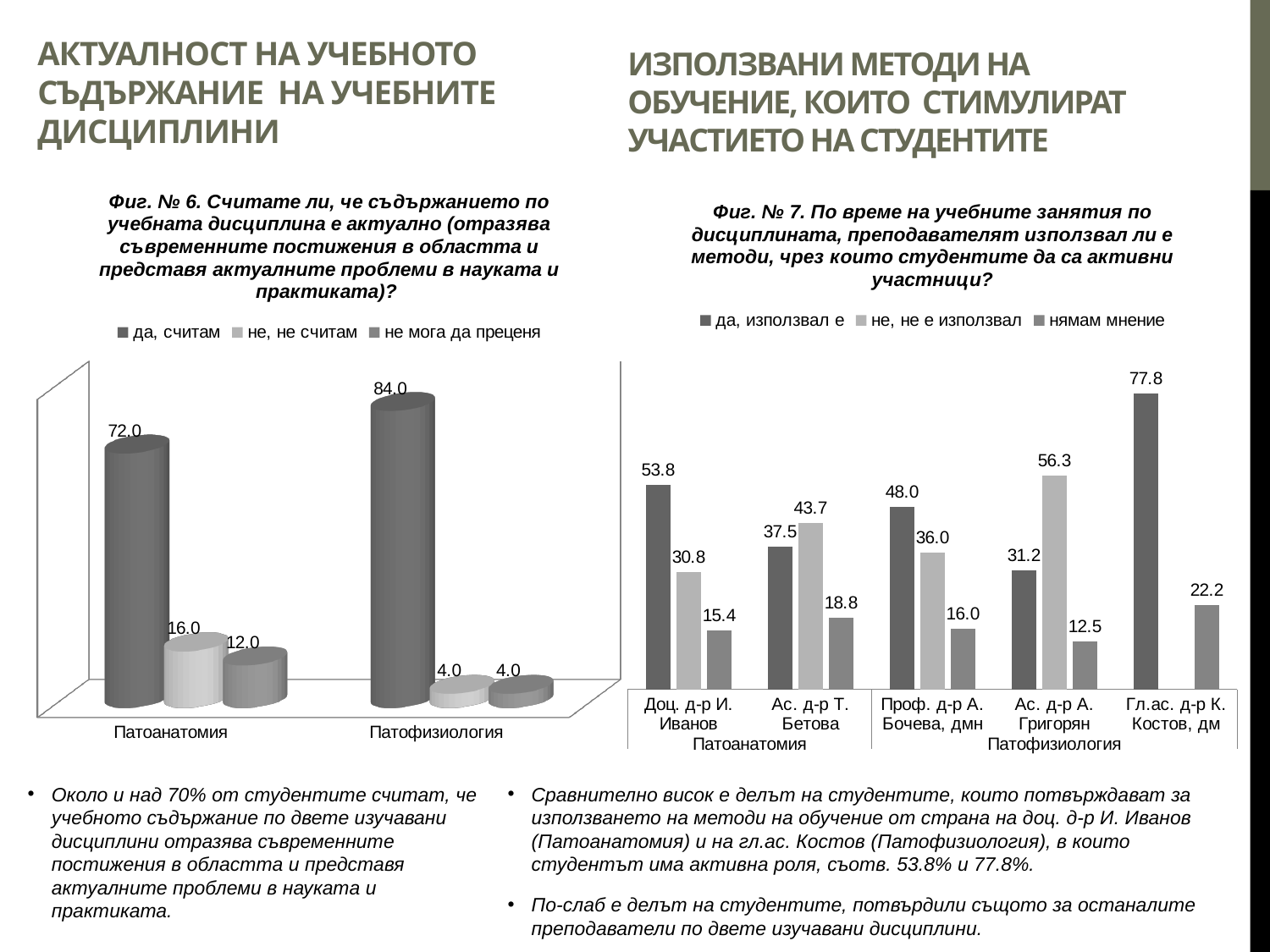
In Фиг. № 7 (right chart), which lecturer has the highest "да, използвал е" value? Гл.ас. д-р К. Костов, дм In Фиг. № 7 (right chart), what is the difference between the "да, използвал е" values for Доц. д-р И. Иванов and Проф. д-р А. Бочева, дмн? 5.8 In Фиг. № 6 (left chart), what is the value of "не, не считам" for Патофизиология? 4.0 In Фиг. № 7 (right chart), what is the value of "да, използвал е" for Гл.ас. д-р К. Костов, дм? 77.8 In Фиг. № 6 (left chart), what is the value of "да, считам" for Патоанатомия? 72.0 In Фиг. № 6 (left chart), how many series does the legend list? 3 In Фиг. № 6 (left chart), what is the difference between the "да, считам" values for Патофизиология and Патоанатомия? 12.0 In Фиг. № 7 (right chart), what is the value of "не, не е използвал" for Ас. д-р А. Григорян? 56.3 In Фиг. № 7 (right chart), how many lecturers are shown on the x axis? 5 In Фиг. № 7 (right chart), which is larger for Ас. д-р Т. Бетова: "да, използвал е" or "не, не е използвал"? не, не е използвал In Фиг. № 7 (right chart), which lecturer has the lowest "да, използвал е" value? Ас. д-р А. Григорян In Фиг. № 6 (left chart), what kind of chart is shown? bar chart